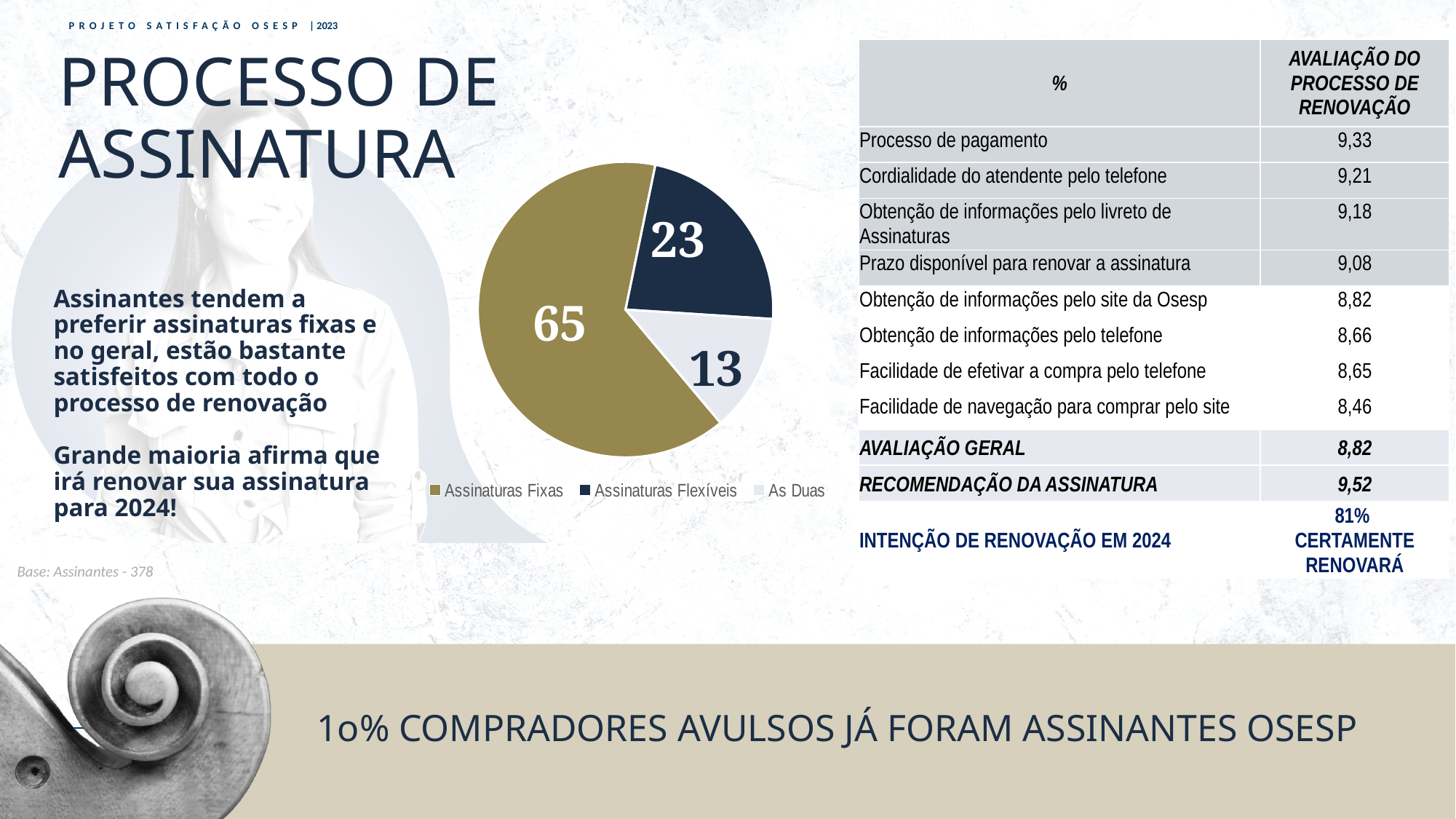
How many entries does the pie chart legend list? 3 What is the value for Assinaturas Fixas in the pie chart? 65 What is the value for Assinaturas Flexíveis in the pie chart? 23 Which category has the largest slice in the pie chart? Assinaturas Fixas How many slices does the pie chart have? 3 What kind of chart is shown on the slide? pie chart Which is larger in the pie chart: Assinaturas Flexíveis or As Duas? Assinaturas Flexíveis What is the difference between the values for Assinaturas Fixas and Assinaturas Flexíveis? 42 What is the difference between the values for Assinaturas Flexíveis and As Duas? 10 Which category has the smallest slice in the pie chart? As Duas What is the value for As Duas in the pie chart? 13 What colour is the Assinaturas Flexíveis slice in the pie chart? dark navy blue